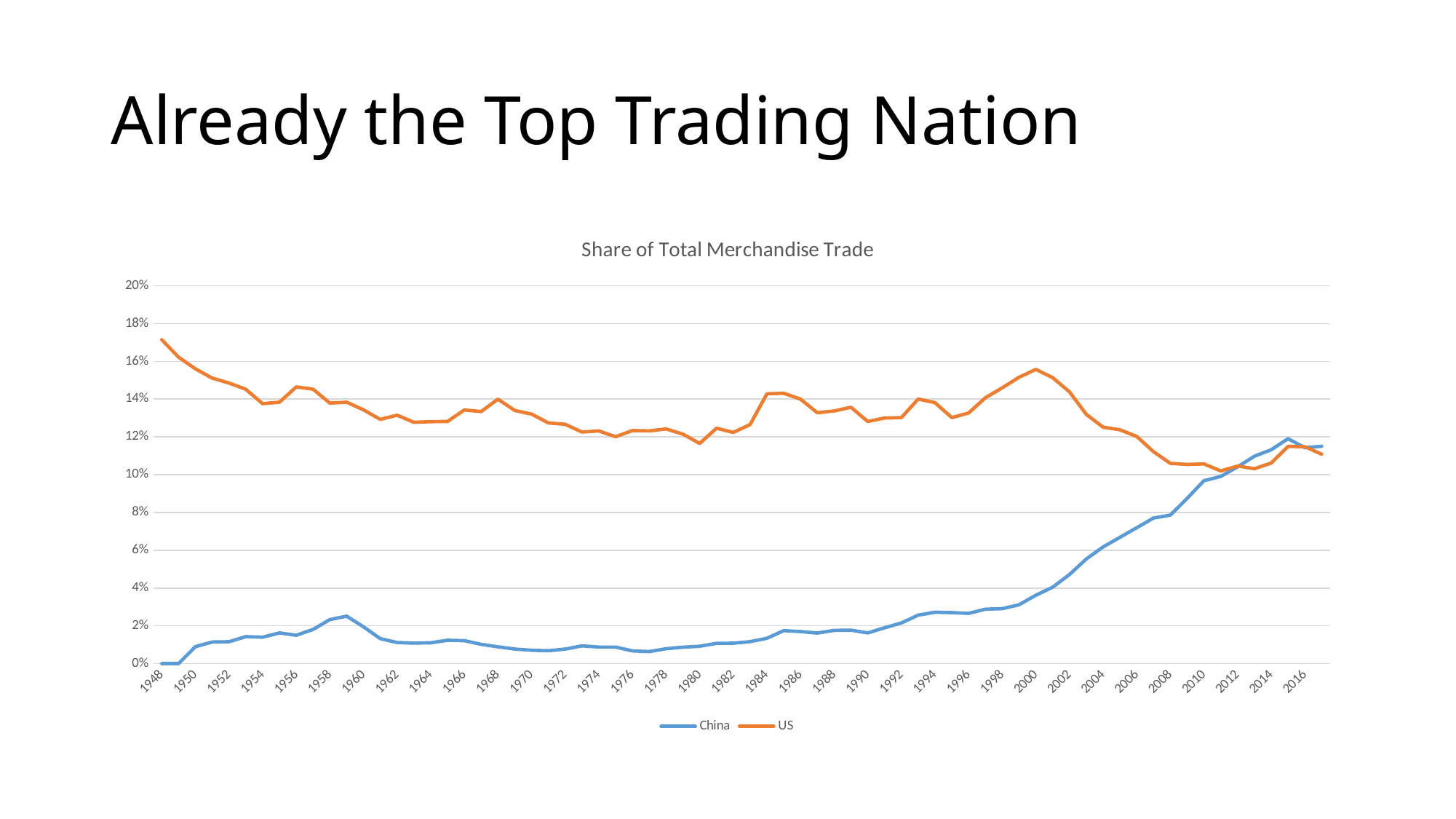
How many series does the legend list? 2 Is the value for US in 1948 greater or less than 16%? greater Is the value for China in 1948 greater or less than 2%? less Which colour is used for the China line? blue Is the value for US in 2008 greater or less than 12%? less What is the title of the chart? Share of Total Merchandise Trade In 1980, which series has the higher share, China or US? US Does China's share rise or fall between 2000 and 2016? rise What kind of chart is shown on the slide? line chart In which year does the US line reach its highest value? 1948